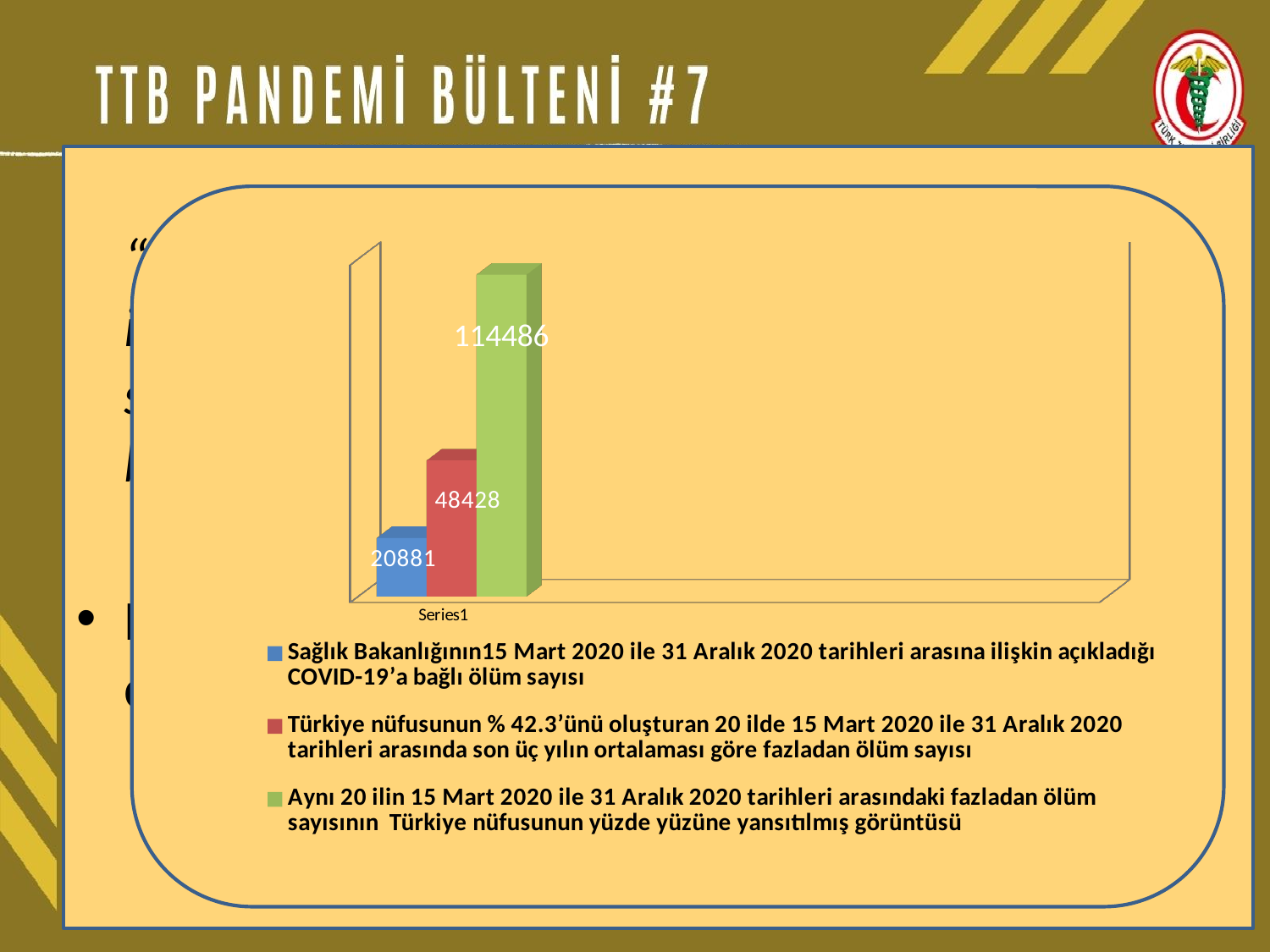
What is the value of the blue bar (Sağlık Bakanlığının 15 Mart 2020 ile 31 Aralık 2020 tarihleri arasına ilişkin açıkladığı COVID-19'a bağlı ölüm sayısı)? 20881 Which series has the lowest value in the chart? Sağlık Bakanlığının 15 Mart 2020 ile 31 Aralık 2020 tarihleri arasına ilişkin açıkladığı COVID-19'a bağlı ölüm sayısı What is the difference between the green bar value and the blue bar value? 93605 Which series has the highest value in the chart? Aynı 20 ilin 15 Mart 2020 ile 31 Aralık 2020 tarihleri arasındaki fazladan ölüm sayısının Türkiye nüfusunun yüzde yüzüne yansıtılmış görüntüsü How many series does the legend list? 3 What is the value of the green bar (fazladan ölüm sayısı projected to 100% of Turkey's population)? 114486 How many bars are plotted in the chart? 3 What colour is the bar representing the Ministry of Health's announced COVID-19 death count? Blue What is the difference between the red bar value and the blue bar value? 27547 What is the value of the red bar (fazladan ölüm sayısı in the 20 provinces making up 42.3% of Turkey's population)? 48428 Which is larger, the red bar value or the blue bar value? The red bar (48428) What kind of chart is shown on the slide? Bar chart